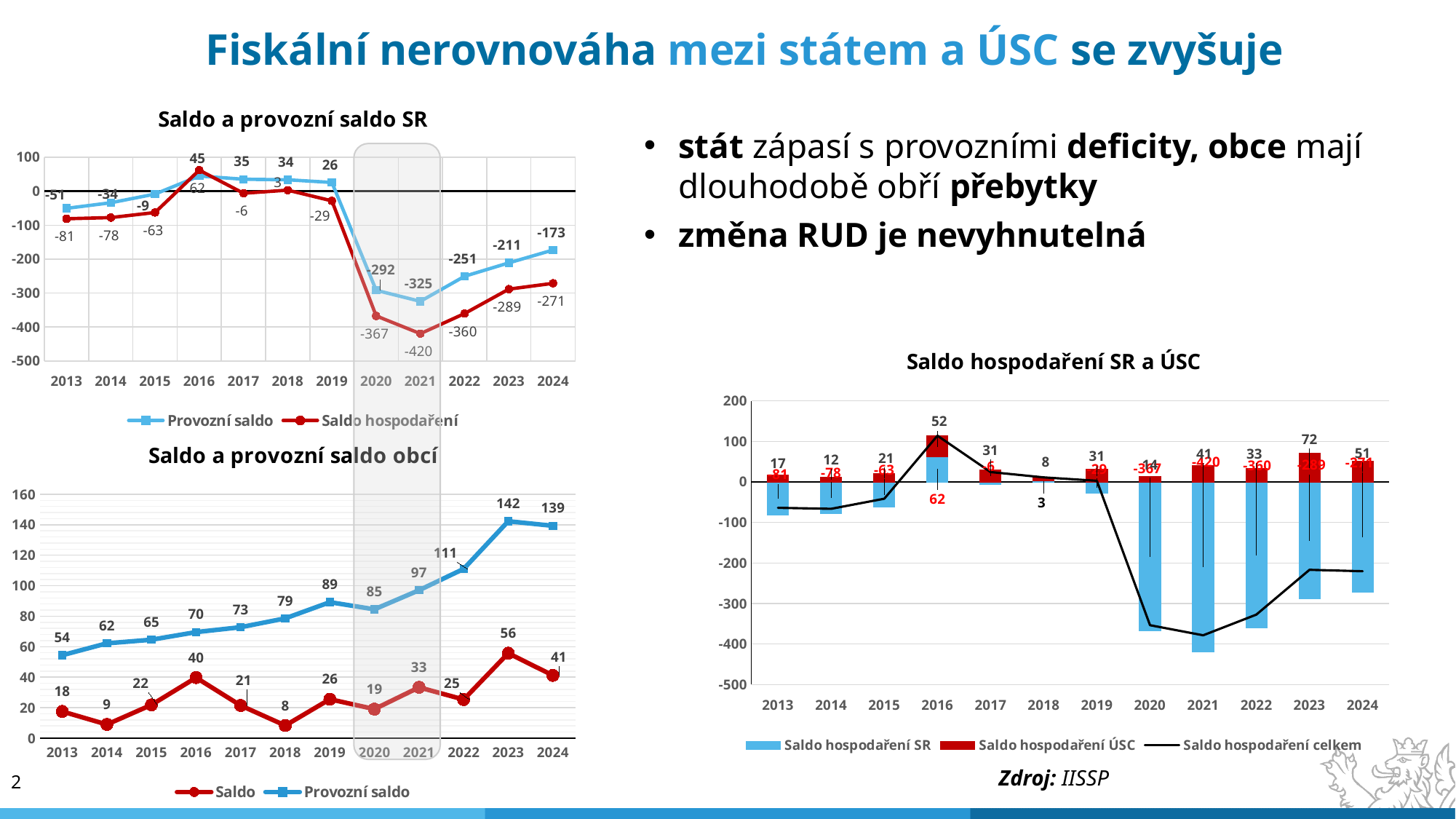
In the chart "Saldo a provozní saldo SR", what is the value of Saldo hospodaření in 2021? -420 In the chart "Saldo hospodaření SR a ÚSC", what is the value of Saldo hospodaření ÚSC in 2023? 72 In the chart "Saldo a provozní saldo SR", which year has the lowest Saldo hospodaření? 2021 How many years are shown on the x axis of the chart "Saldo a provozní saldo obcí"? 12 How many series does the legend of the chart "Saldo hospodaření SR a ÚSC" list? 3 In the chart "Saldo a provozní saldo obcí", does Provozní saldo rise or fall from 2013 to 2019? rise In the chart "Saldo a provozní saldo SR", what is the value of Provozní saldo in 2016? 45 In the chart "Saldo hospodaření SR a ÚSC", is the Saldo hospodaření SR bar for 2020 greater or less than -300? less In the chart "Saldo a provozní saldo obcí", which year has the highest Saldo? 2023 In the chart "Saldo a provozní saldo obcí", what is the value of Provozní saldo in 2023? 142 In the chart "Saldo a provozní saldo SR", what is the difference between Provozní saldo in 2020 and in 2021? 33 What kind of chart is "Saldo a provozní saldo SR"? line chart